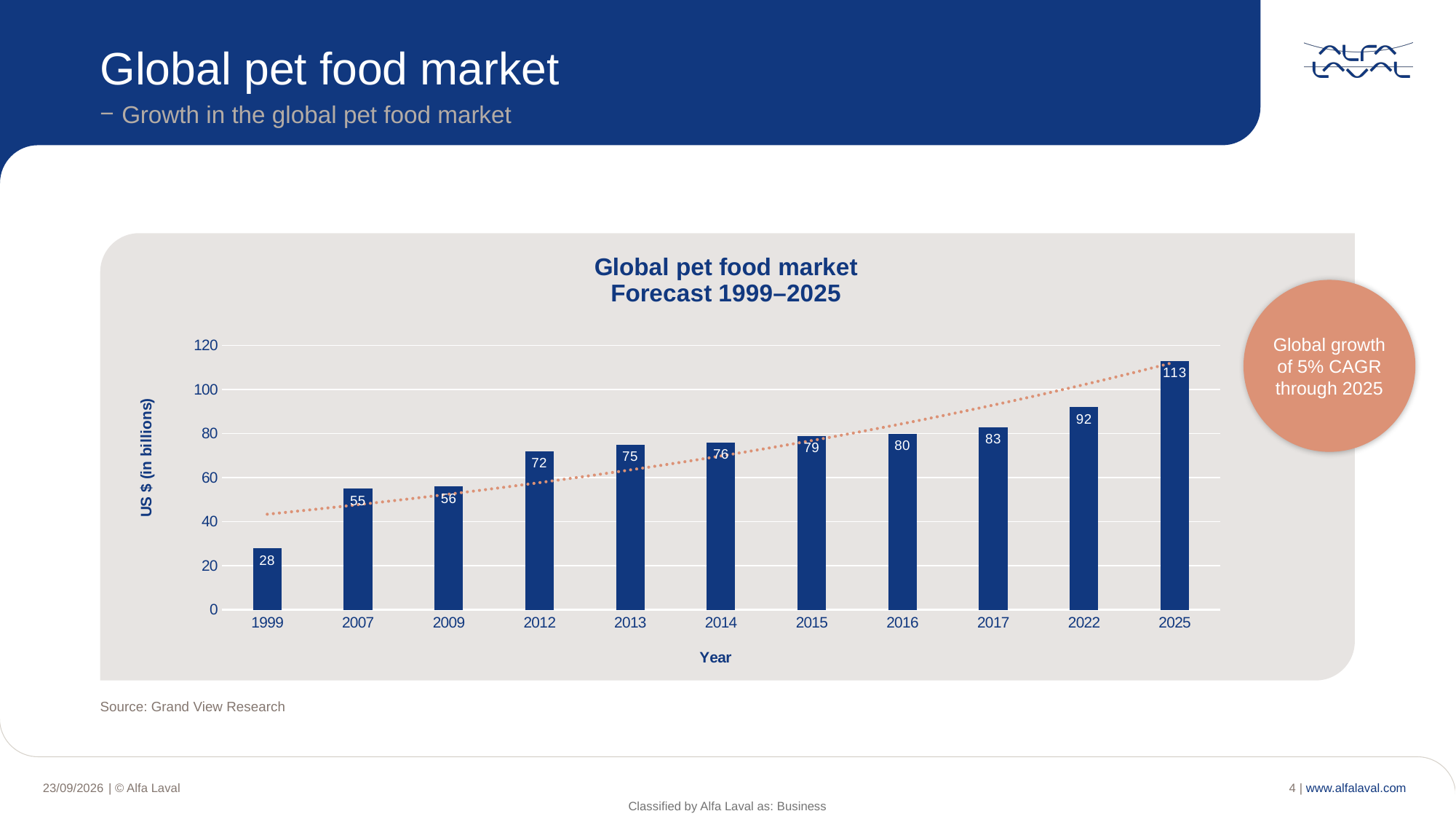
Is the value for 2022 greater or less than 100? less What is the value for 1999? 28 Which year has the highest value? 2025 How many years are shown on the x axis? 11 What is the value for 2025? 113 What is the difference between the values for 2025 and 1999? 85 Which year has the lowest value? 1999 Do the values rise or fall from 1999 to 2025? rise What kind of chart is this? bar chart What is the label of the y axis? US $ (in billions) What is the value for 2013? 75 Which is larger, the value for 2022 or the value for 2017? 2022